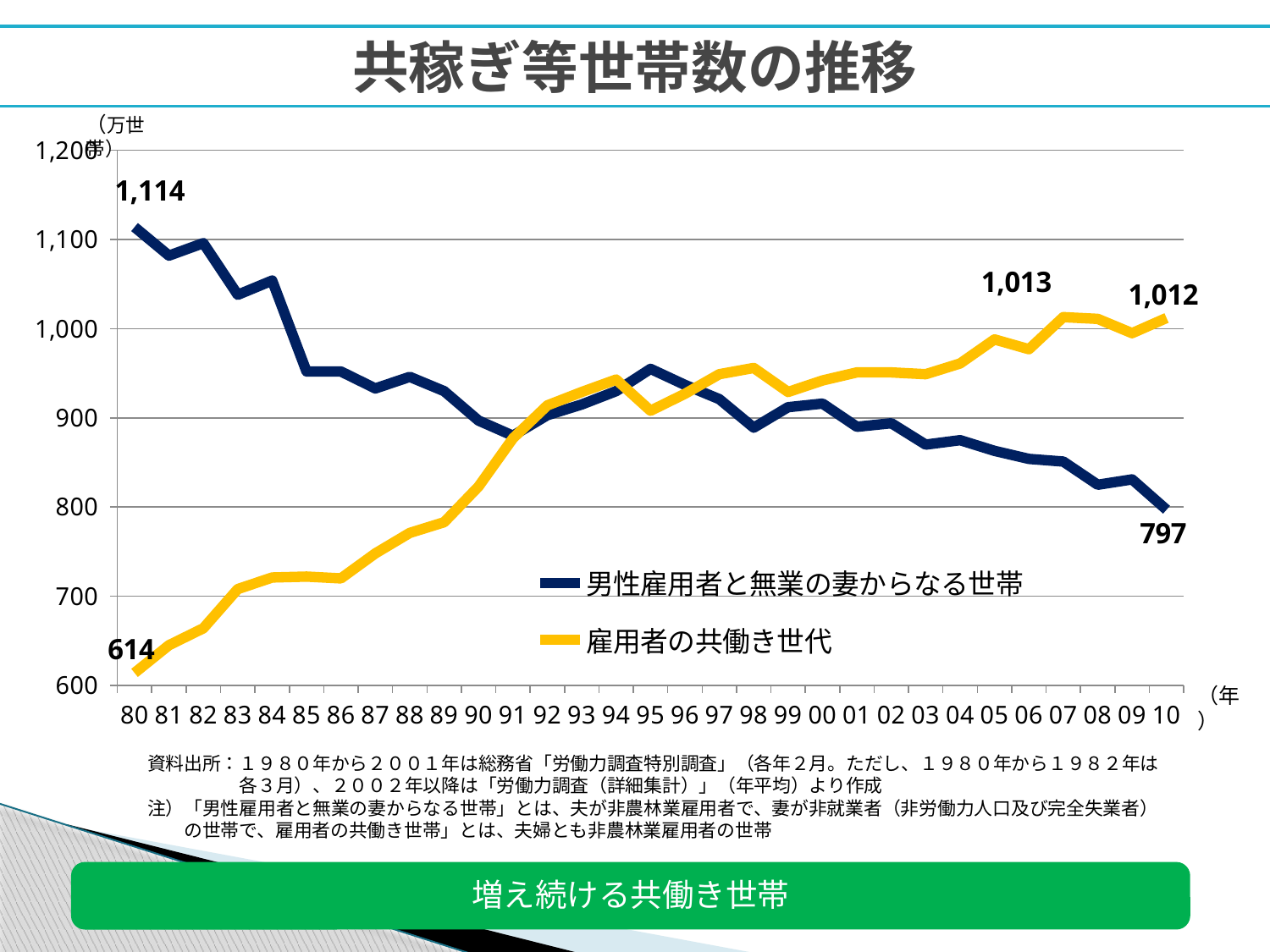
What is the value for 男性雇用者と無業の妻からなる世帯 in 1980 (80)? 1,114 What is the title of the chart? 共稼ぎ等世帯数の推移 By how much did 男性雇用者と無業の妻からなる世帯 decrease from 1980 to 2010? 317 In 2010, which series has the higher value? 雇用者の共働き世代 What is the value for 雇用者の共働き世代 in 2010 (10)? 1,012 Does the 男性雇用者と無業の妻からなる世帯 series generally rise or fall from 1980 to 2010? fall What is the value for 男性雇用者と無業の妻からなる世帯 in 2010 (10)? 797 By how much did 雇用者の共働き世代 increase from 1980 to 2010? 398 What is the value for 雇用者の共働き世代 in 1980 (80)? 614 How many series does the legend list? 2 What kind of chart is shown on the slide? line chart Is the value for 雇用者の共働き世代 in 1986 (86) greater or less than 800? less